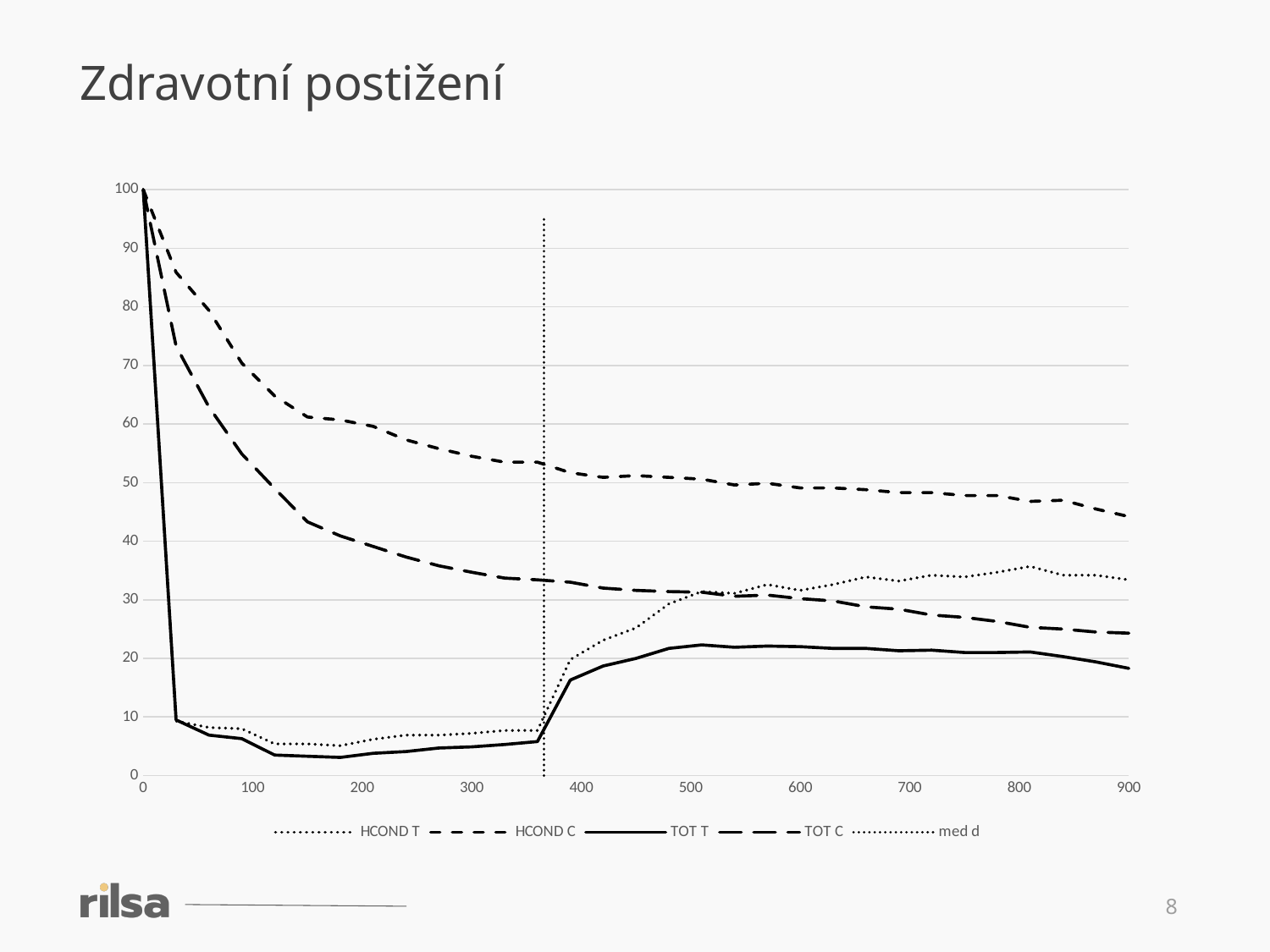
Is the value of TOT T at x = 900 greater or less than 20? less Is the value of TOT C at x = 900 greater or less than 30? less How many series does the legend list? 5 What value do the HCOND C, HCOND T, TOT T and TOT C series all start at when x is 0? 100 What is the title of the chart on the slide? Zdravotní postižení Does the HCOND C series rise or fall overall from x = 0 to x = 900? fall Is the value of HCOND C at x = 900 greater or less than 40? greater What kind of chart is shown on the slide? line chart At x = 900, which is larger, HCOND C or TOT C? HCOND C Which series has the highest value at x = 900? HCOND C Which series are listed in the chart legend? HCOND T, HCOND C, TOT T, TOT C, med d